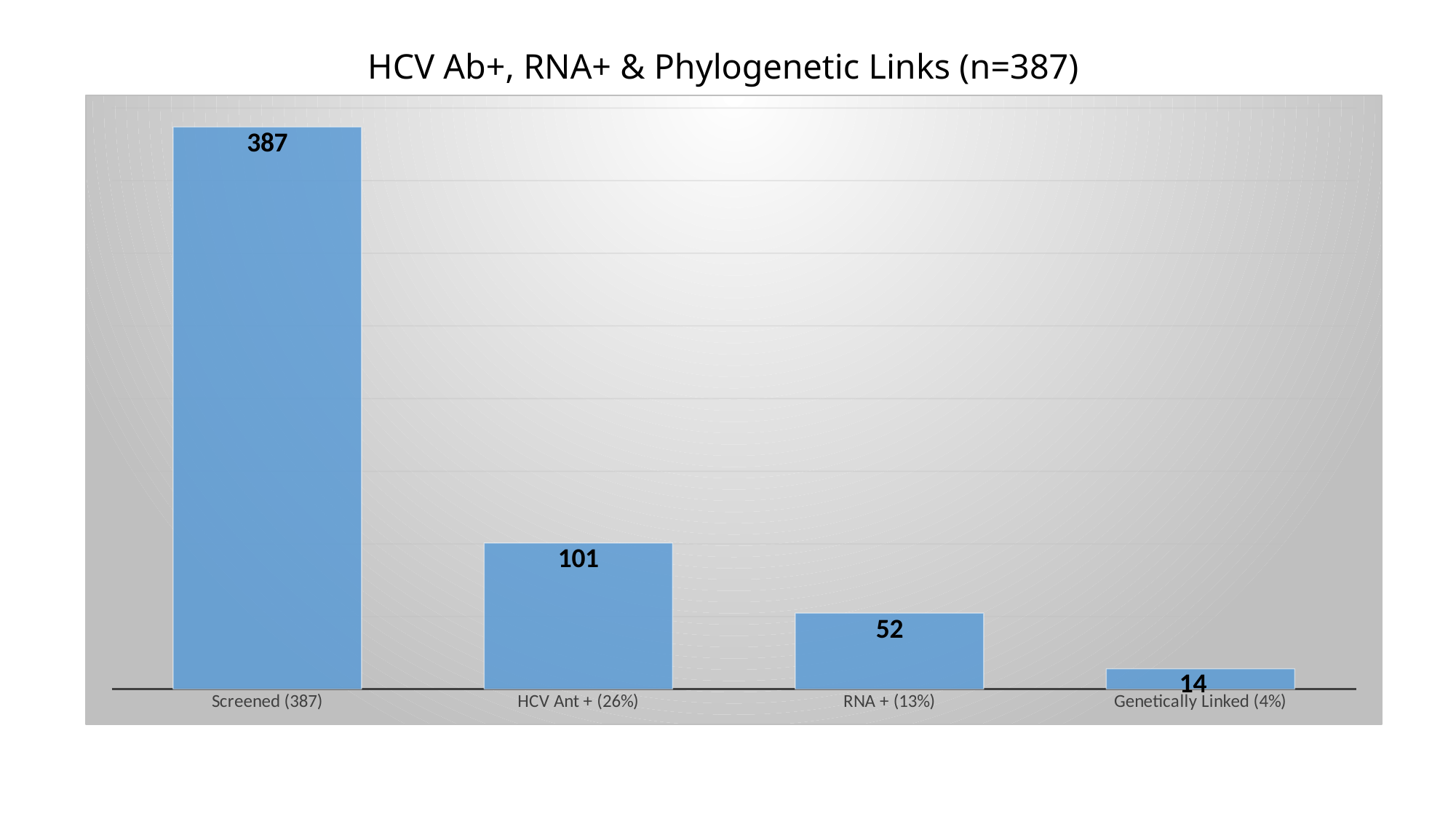
What is the difference between the values for HCV Ant + (26%) and RNA + (13%)? 49 What is the difference between the values for Screened (387) and HCV Ant + (26%)? 286 Which category has the highest value? Screened (387) What is the value for HCV Ant + (26%)? 101 Which category has the lowest value? Genetically Linked (4%) What is the value for RNA + (13%)? 52 What is the title of the chart? HCV Ab+, RNA+ & Phylogenetic Links (n=387) What is the value for Screened (387)? 387 What is the value for Genetically Linked (4%)? 14 What kind of chart is shown on the slide? bar chart How many categories are shown in the chart? 4 Which is larger, the value for RNA + (13%) or the value for Genetically Linked (4%)? RNA + (13%)